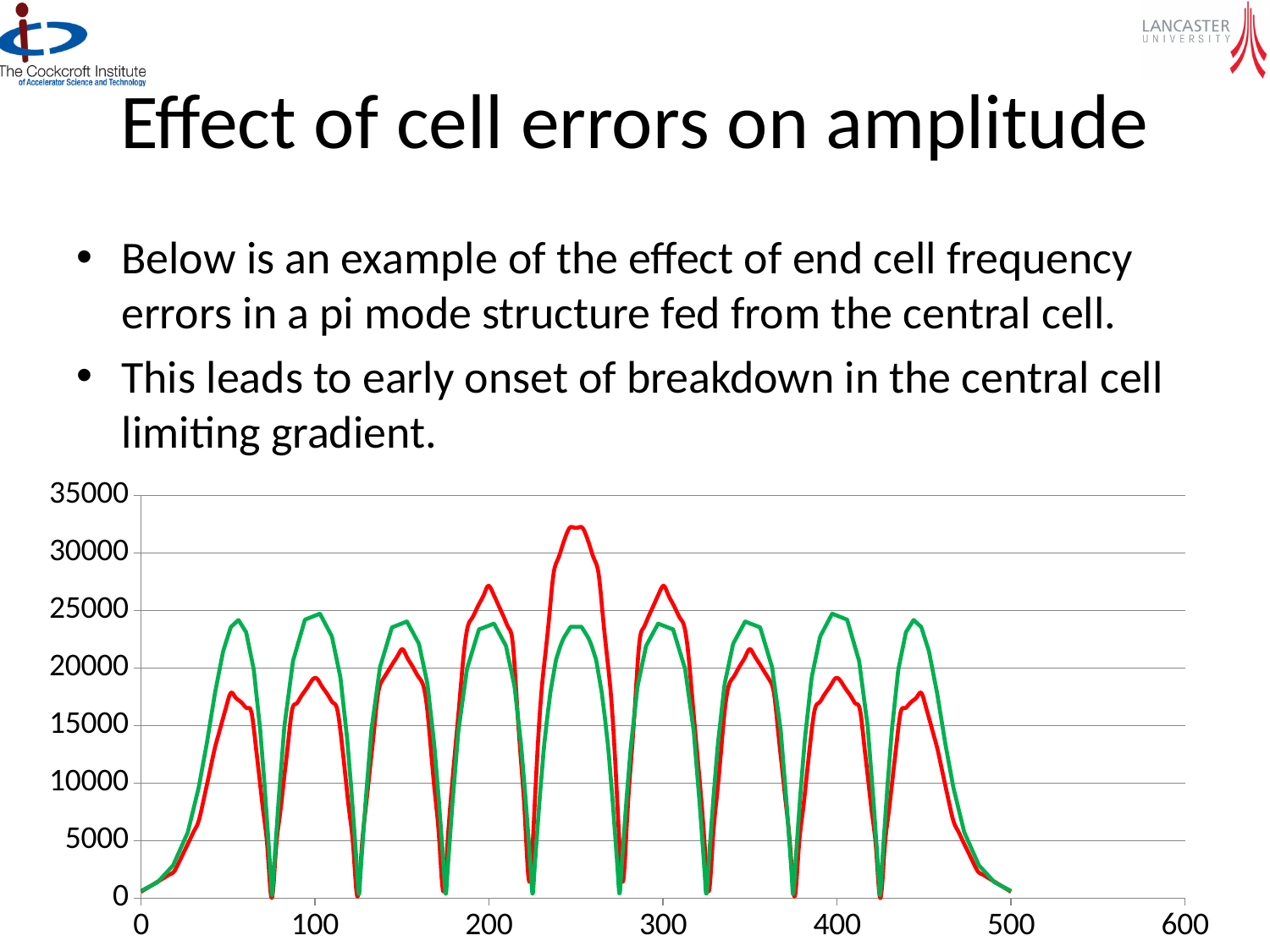
How many peaks does the red line have? 9 Which line has the highest peak on the chart, red or green? red At x = 50, which line reaches the higher value, red or green? green Is the highest peak of the red line (near x = 250) greater or less than 30000? greater At x = 250, which line reaches the higher value, red or green? red How many lines are plotted on the chart? 2 What kind of chart is shown on the slide? line chart Is the peak of the green line near x = 250 greater or less than 25000? less What colours are the two lines on the chart? red and green What is the highest value labelled on the vertical axis? 35000 Is the peak of the red line near x = 50 greater or less than 20000? less